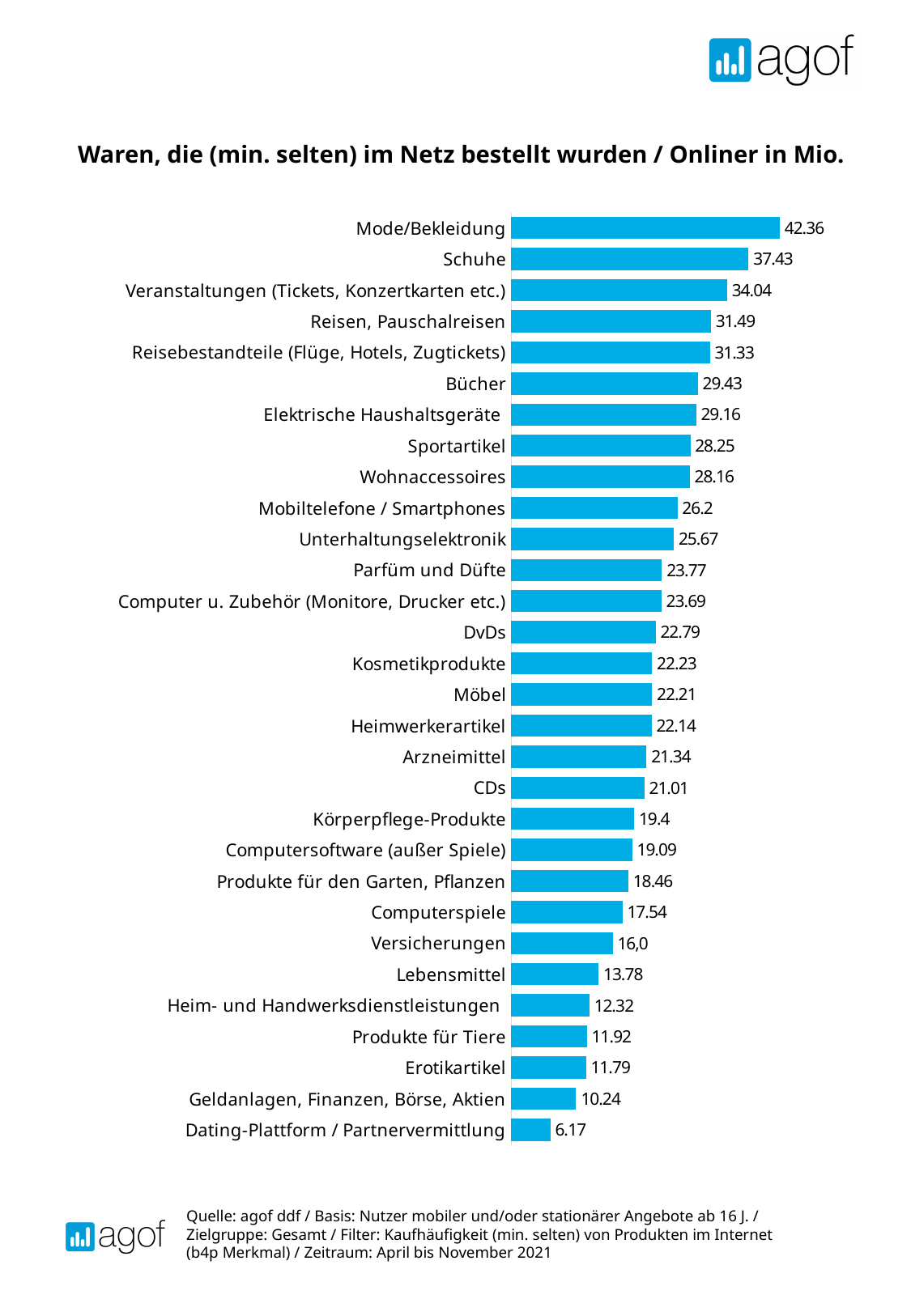
How many categories are shown in the chart? 30 What is the value for Mode/Bekleidung? 42.36 What kind of chart is shown on the slide? Bar chart What is the value for Lebensmittel? 13.78 Which category has the highest value? Mode/Bekleidung Which category has the lowest value? Dating-Plattform / Partnervermittlung What is the difference between the values for Mode/Bekleidung and Schuhe? 4.93 What is the title of the chart? Waren, die (min. selten) im Netz bestellt wurden / Onliner in Mio. What is the difference between the values for Bücher and Dating-Plattform / Partnervermittlung? 23.26 What is the value for Versicherungen? 16,0 Which has a larger value, Computerspiele or Lebensmittel? Computerspiele Which has a larger value, Erotikartikel or Geldanlagen, Finanzen, Börse, Aktien? Erotikartikel